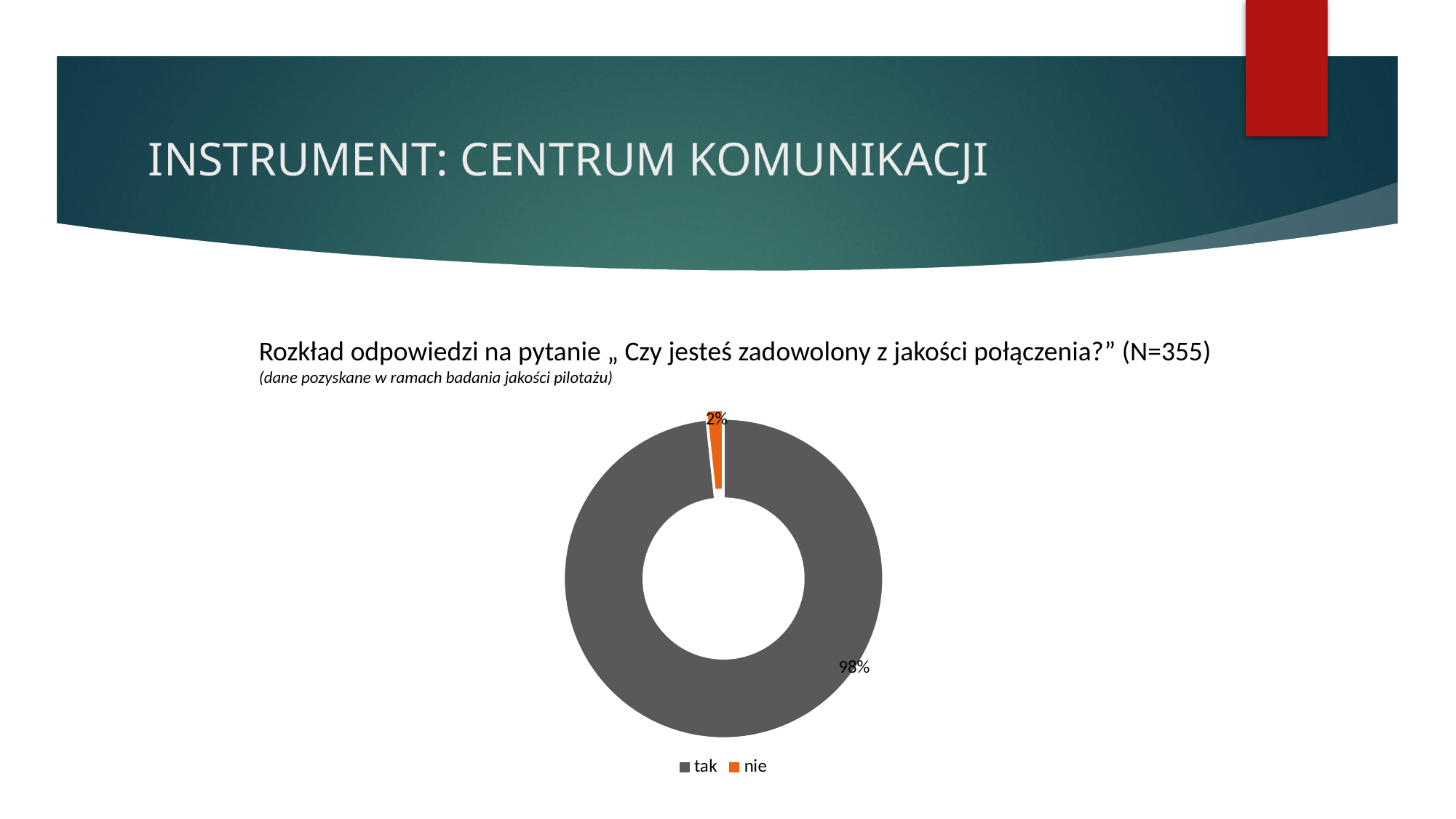
Which answer has the smallest share of the chart? nie What is the difference in percentage points between the "tak" and "nie" shares? 96 What percentage of respondents answered "nie"? 2% What percentage of respondents answered "tak"? 98% How many categories does the chart show? 2 Which share is larger, "tak" or "nie"? tak What share of the chart does the "nie" slice represent? 2% How many respondents (N) does the chart title state? 355 Which answer has the largest share of the chart? tak What colour is the "nie" slice in the chart? Orange What kind of chart is shown on the slide? Doughnut (pie) chart